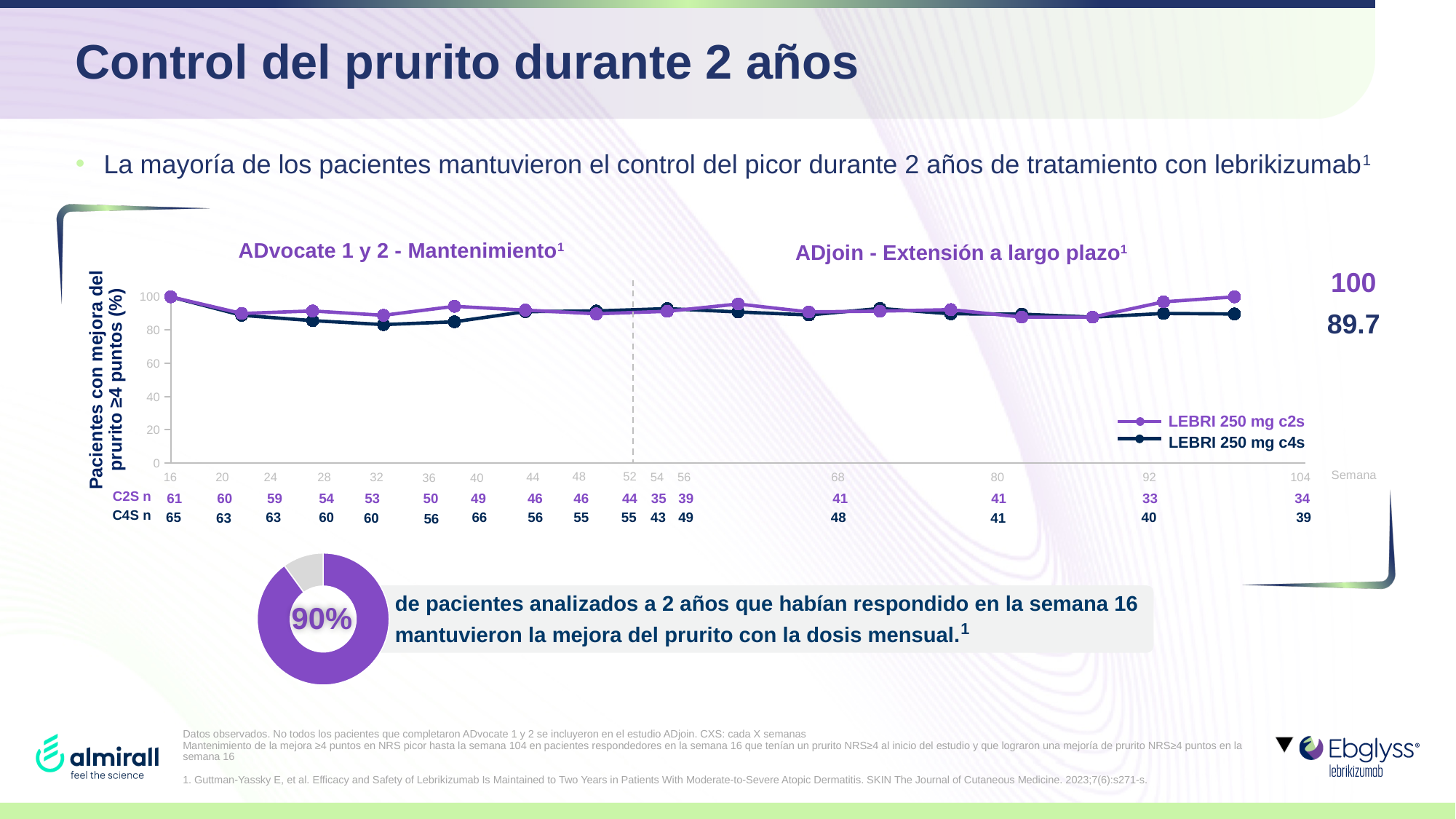
What kind of chart is used to show patients with pruritus improvement over the weeks? line chart What are the two legend entries of the line chart? LEBRI 250 mg c2s and LEBRI 250 mg c4s At week 104, which series has the higher value, LEBRI 250 mg c2s or LEBRI 250 mg c4s? LEBRI 250 mg c2s What percentage does the donut chart at the bottom of the slide show? 90% What is the value for LEBRI 250 mg c2s at week 104 in the line chart? 100 Is the value for LEBRI 250 mg c2s at week 16 greater or less than 80? greater What is the difference between the LEBRI 250 mg c2s and LEBRI 250 mg c4s values at week 104? 10.3 What is the C2S n value shown under week 16 in the line chart? 61 How many series does the legend of the line chart list? 2 What is the C4S n value shown under week 104 in the line chart? 39 What is the value for LEBRI 250 mg c4s at week 104 in the line chart? 89.7 Is the value for LEBRI 250 mg c4s at week 32 greater or less than 60? greater